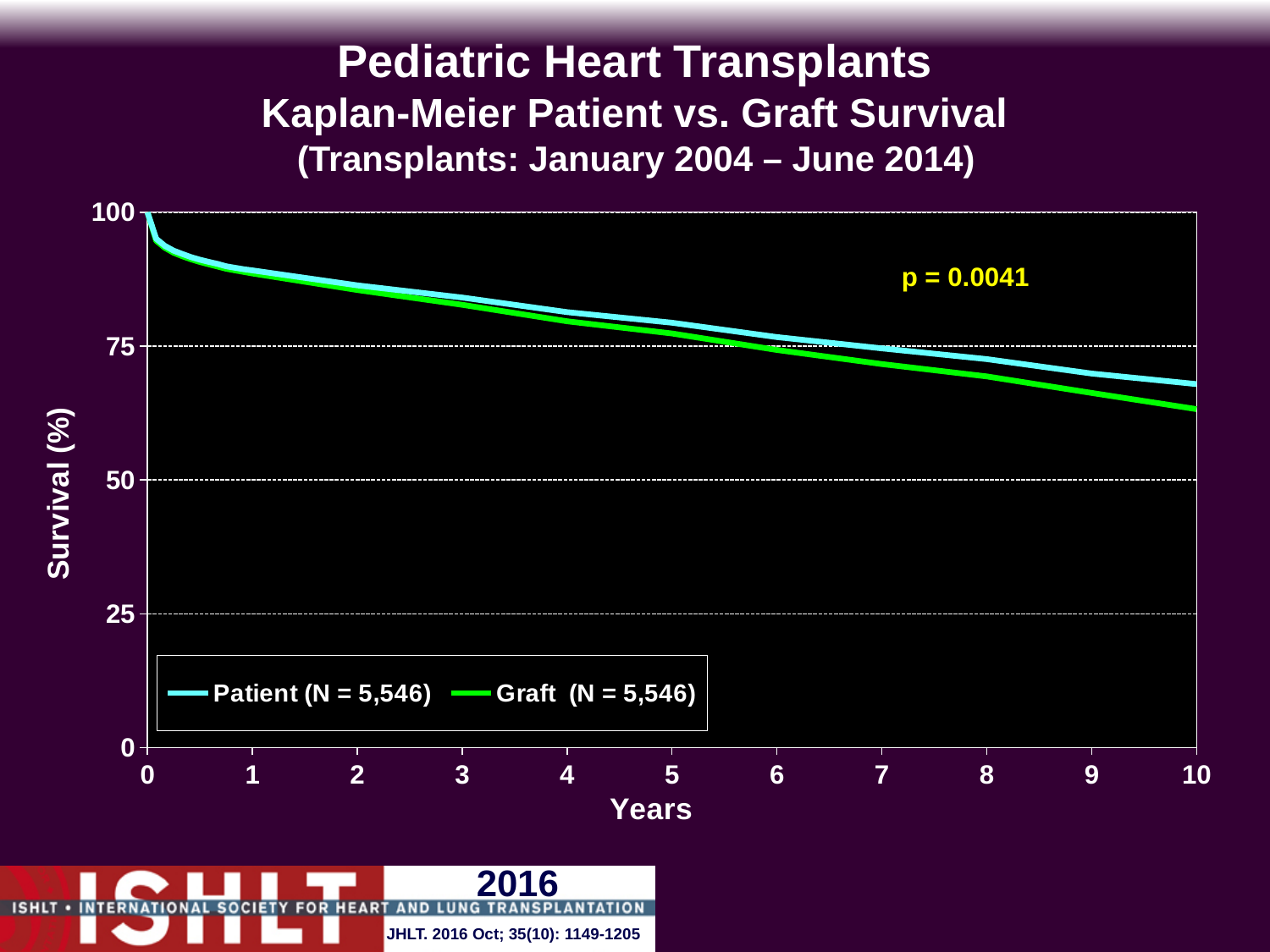
At 9 years, which series has the lower survival, Patient or Graft? Graft How many series does the legend list? 2 Is the Graft survival value at 10 years greater or less than 50? greater What kind of chart is shown on the slide? line chart What p-value is shown on the chart? p = 0.0041 Is the Graft survival value at 8 years greater or less than 75? less At 10 years, which series has the higher survival, Patient or Graft? Patient Is the Patient survival value at 1 year greater or less than 75? greater Do the survival curves rise or fall as years increase? fall What is the N shown for the Patient series in the legend? 5,546